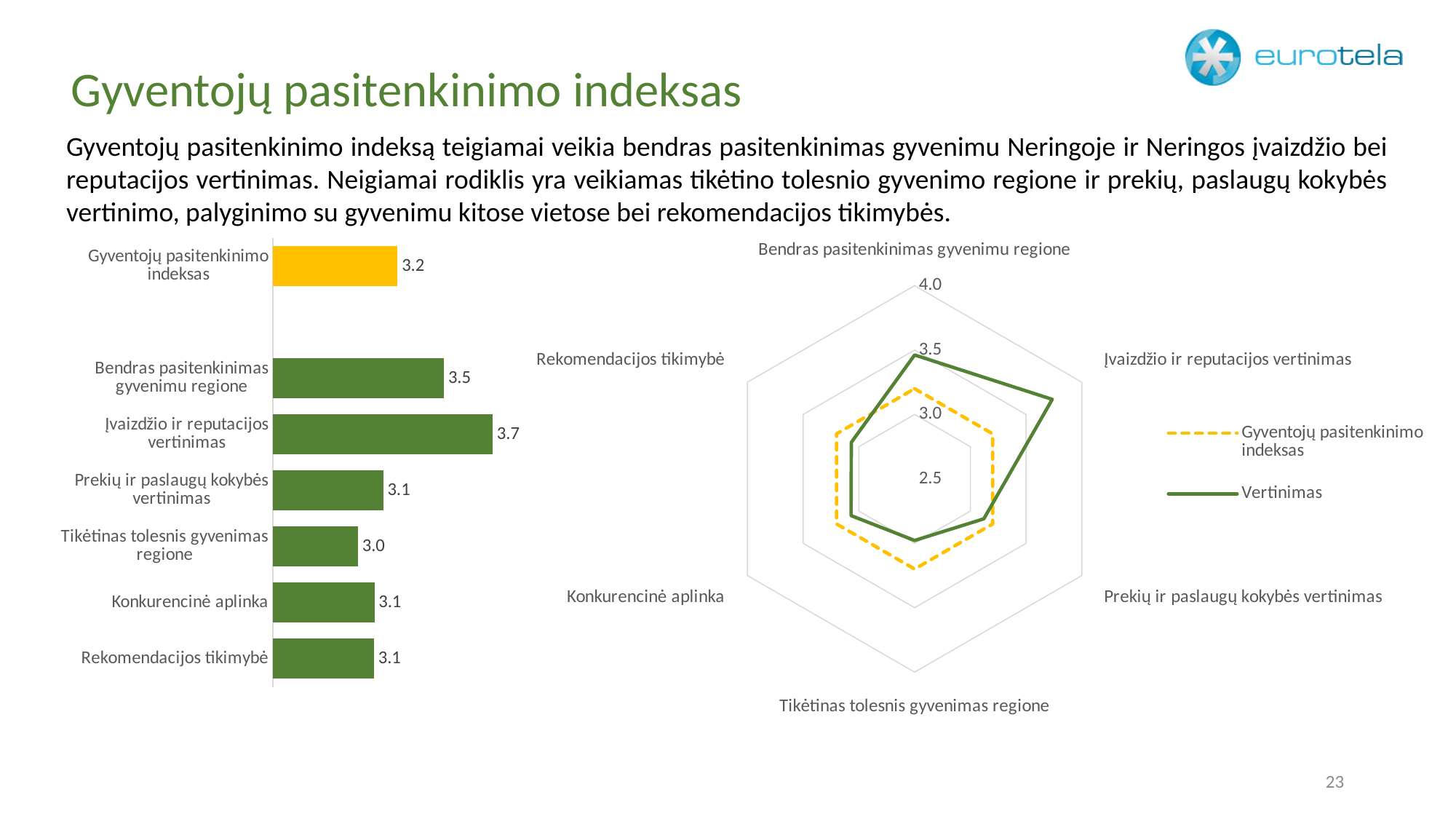
In the bar chart on the left, which category has the highest value? Įvaizdžio ir reputacijos vertinimas In the bar chart on the left, which is larger: Bendras pasitenkinimas gyvenimu regione or Prekių ir paslaugų kokybės vertinimas? Bendras pasitenkinimas gyvenimu regione How many series does the legend of the radar chart on the right list? 2 In the radar chart on the right, is the Vertinimas value for Įvaizdžio ir reputacijos vertinimas greater or less than 3.5? greater In the bar chart on the left, what is the value for Įvaizdžio ir reputacijos vertinimas? 3.7 What kind of chart is on the right side of the slide? Radar chart In the bar chart on the left, what is the value for Gyventojų pasitenkinimo indeksas? 3.2 In the bar chart on the left, which category has the lowest value? Tikėtinas tolesnis gyvenimas regione In the bar chart on the left, what is the value for Tikėtinas tolesnis gyvenimas regione? 3.0 What kind of chart is on the left side of the slide? Bar chart How many bars are shown in the bar chart on the left? 7 In the bar chart on the left, what is the difference between Įvaizdžio ir reputacijos vertinimas and Bendras pasitenkinimas gyvenimu regione? 0.2